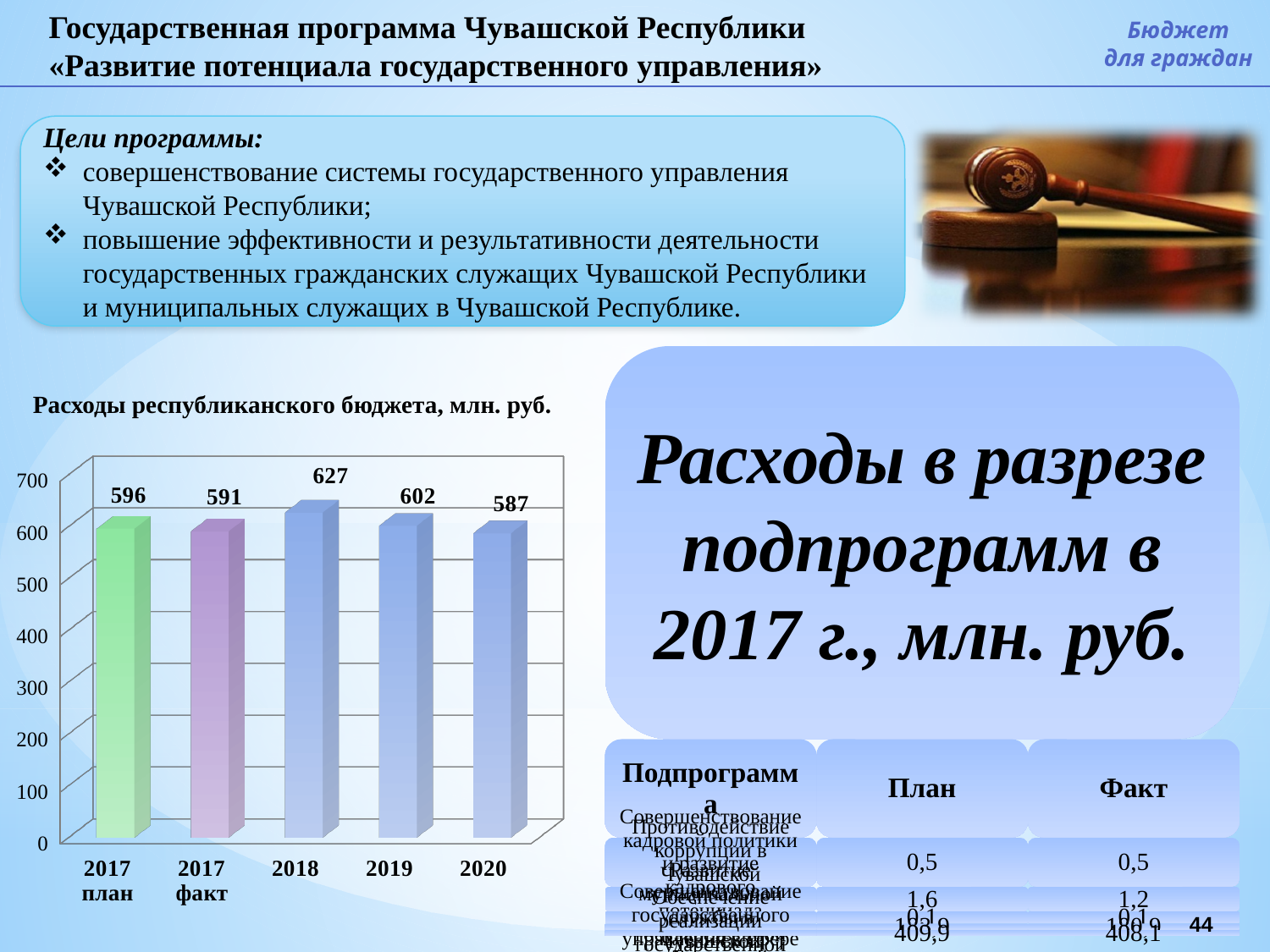
In the chart 'Расходы республиканского бюджета, млн. руб.', which is larger: the value for 2019 or the value for 2020? 2019 What is the value for 2017 факт in the chart 'Расходы республиканского бюджета, млн. руб.'? 591 Which category has the highest value in the chart 'Расходы республиканского бюджета, млн. руб.'? 2018 What type of chart is 'Расходы республиканского бюджета, млн. руб.'? bar chart What is the difference between the 2018 and 2019 values in the chart 'Расходы республиканского бюджета, млн. руб.'? 25 Which category has the lowest value in the chart 'Расходы республиканского бюджета, млн. руб.'? 2020 Is the value for 2018 in the chart 'Расходы республиканского бюджета, млн. руб.' greater or less than 600? greater What is the value for 2018 in the chart 'Расходы республиканского бюджета, млн. руб.'? 627 What is the difference between the 2017 план and 2017 факт values in the chart 'Расходы республиканского бюджета, млн. руб.'? 5 How many bars are shown in the chart 'Расходы республиканского бюджета, млн. руб.'? 5 What is the value for 2020 in the chart 'Расходы республиканского бюджета, млн. руб.'? 587 What is the value for 2017 план in the chart 'Расходы республиканского бюджета, млн. руб.'? 596